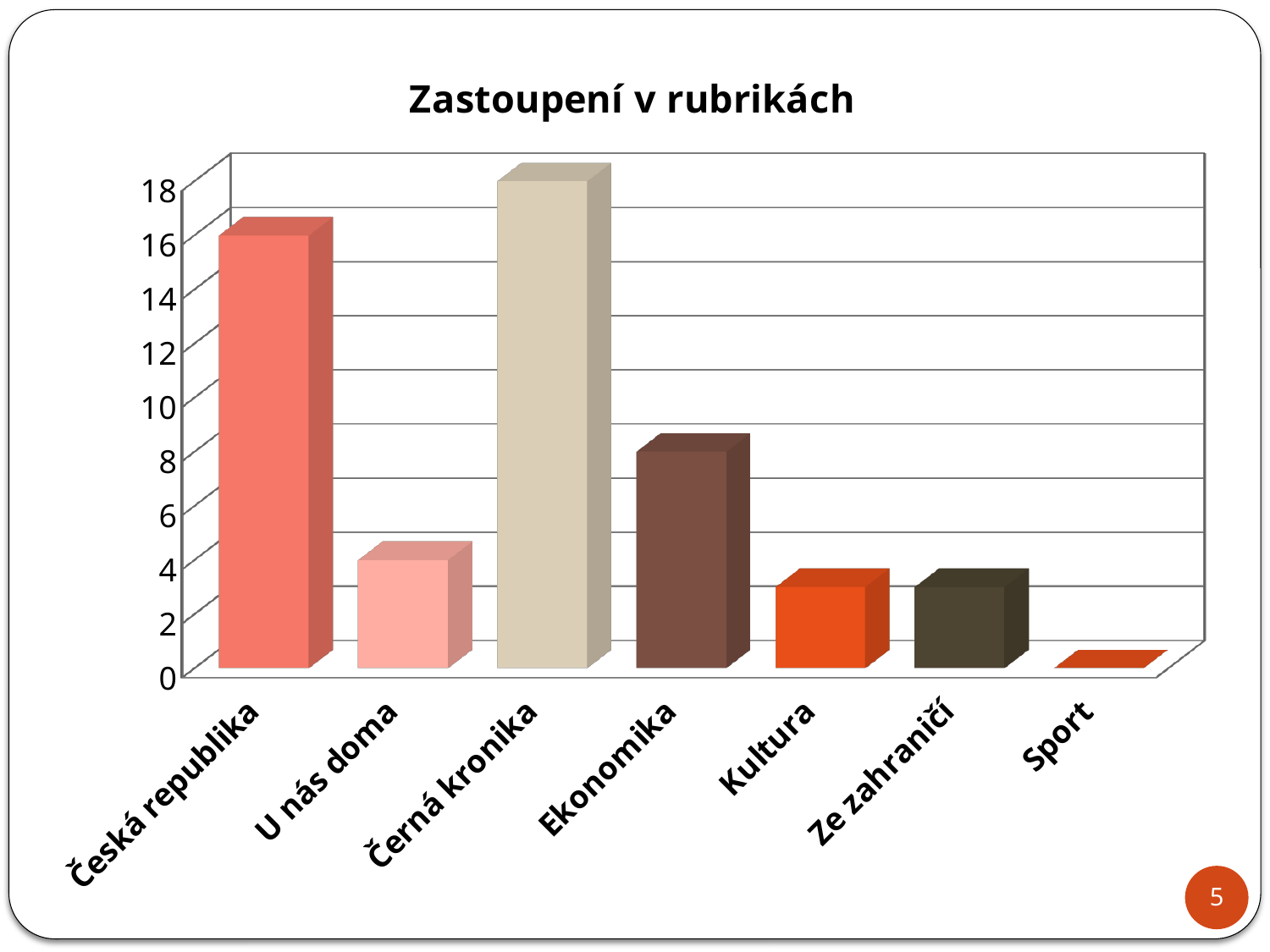
Which category has the lowest value in the chart? Sport What is the title of the chart? Zastoupení v rubrikách Is the value for Ekonomika greater or less than 10? less Is the value for Kultura greater or less than 6? less Which is larger, the value for Česká republika or the value for Ekonomika? Česká republika How many categories are shown on the x axis of the chart? 7 Is the value for U nás doma greater or less than 6? less What type of chart is shown on the slide? bar chart Which is larger, the value for U nás doma or the value for Černá kronika? Černá kronika Which category has the highest value in the chart? Černá kronika